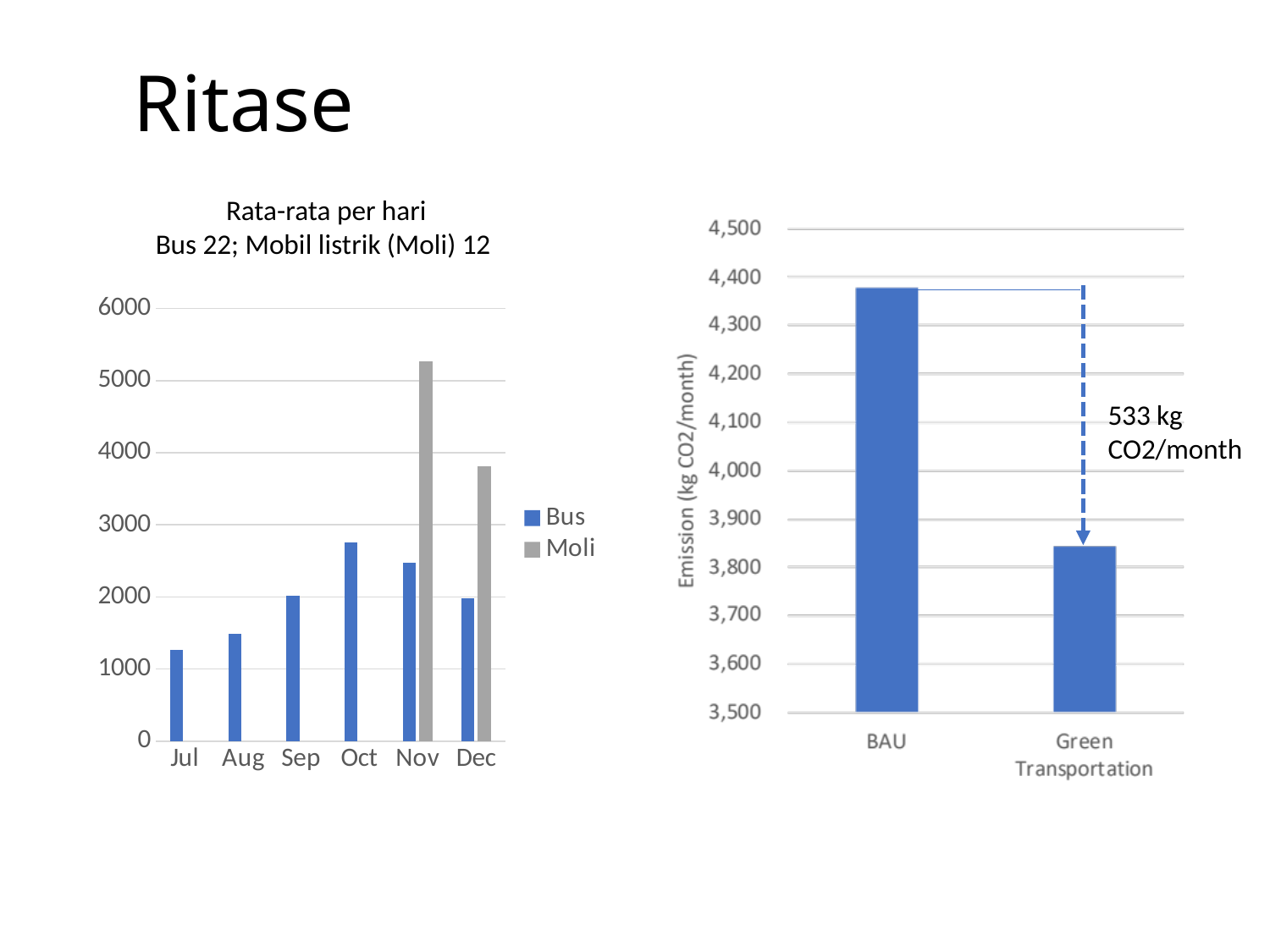
On the left chart (Rata-rata per hari), how many months are shown on the x axis? 6 What kind of chart is the right chart showing Emission (kg CO2/month)? bar chart On the left chart (Rata-rata per hari), is the Moli value for Dec greater or less than 4000? less On the left chart (Rata-rata per hari), is the Bus value for Oct greater or less than 3000? less On the left chart (Rata-rata per hari), is the Moli value for Nov greater or less than 5000? greater On the right chart (Emission), what reduction is annotated between BAU and Green Transportation? 533 kg CO2/month On the left chart (Rata-rata per hari), in which month is the Bus value lowest? Jul On the left chart (Rata-rata per hari), which is larger in Nov, the Bus value or the Moli value? Moli On the left chart (Rata-rata per hari), how many series does the legend list? 2 On the left chart (Rata-rata per hari), what are the two series named in the legend? Bus and Moli On the left chart (Rata-rata per hari), in which month is the Bus value highest? Oct